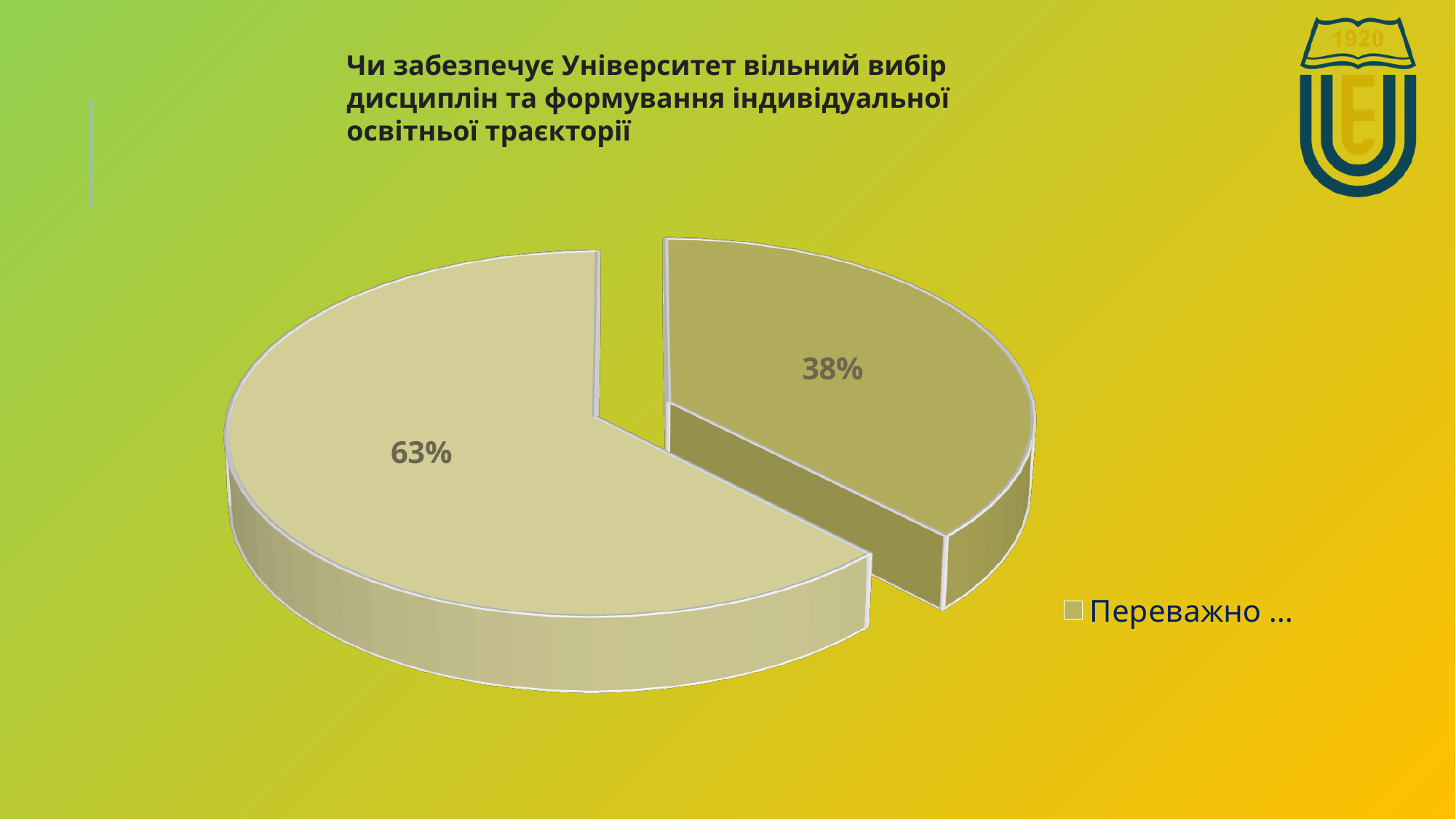
What is the value shown on the smallest slice of the pie chart? 38% What percentage is printed on the right, separated slice of the pie chart? 38% By how many percentage points does the larger slice exceed the smaller slice? 25 Is the pie chart drawn in 3D or flat 2D? 3D What is the value shown on the largest slice of the pie chart? 63% What kind of chart is shown on the slide? pie chart How many slices does the pie chart have? 2 What is the title of the chart? Чи забезпечує Університет вільний вибір дисциплін та формування індивідуальної освітньої траєкторії Is the value of the right separated slice greater or less than 50%? less Is the value of the left slice greater or less than 50%? greater Which slice is larger, the left slice or the right separated slice? the left slice What percentage is printed on the left slice of the pie chart? 63%